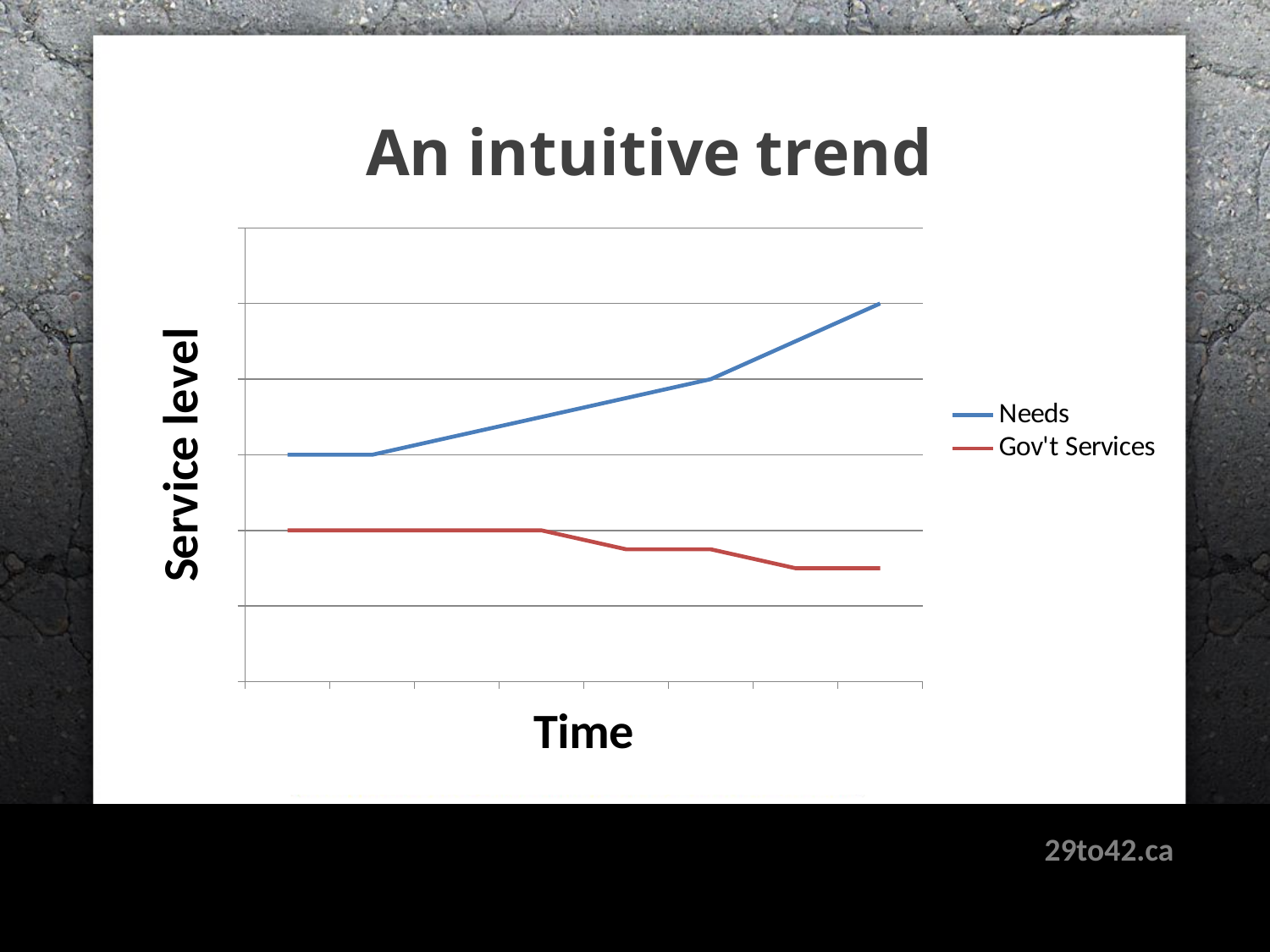
At the left end of the Time axis, which series has the higher service level: Needs or Gov't Services? Needs What is the title of the chart on the slide? An intuitive trend Does the Needs series rise or fall along the Time axis? rise Does the gap between Needs and Gov't Services widen or narrow over time? widen What kind of chart is shown on the slide? line chart At the right end of the Time axis, which series is higher: Needs or Gov't Services? Needs Which series reaches the highest service level on the chart? Needs What is the label of the vertical axis? Service level Does the Gov't Services series rise or fall along the Time axis? fall Which series has the lowest service level on the chart? Gov't Services How many series does the legend list? 2